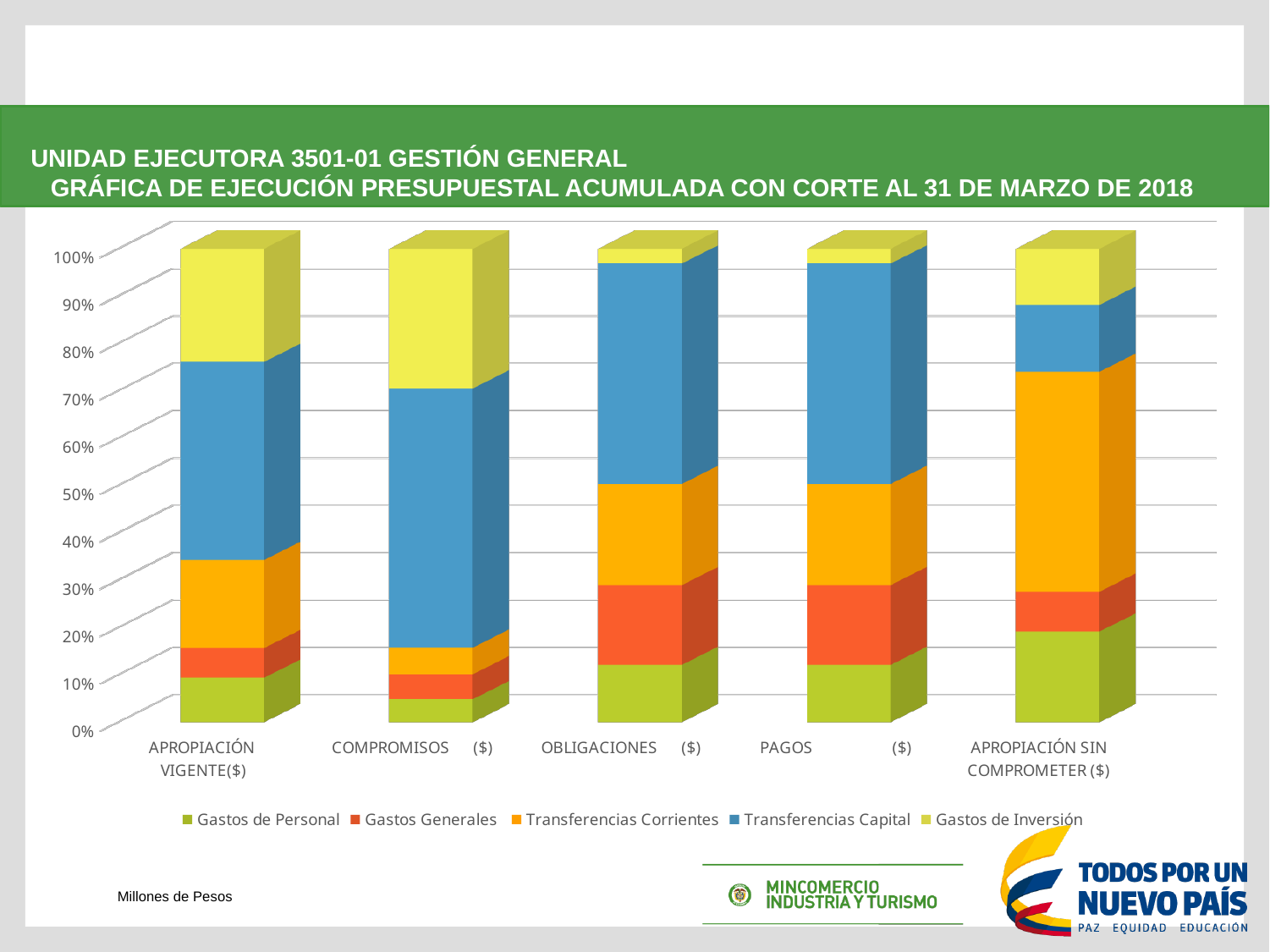
Is the Gastos de Inversión share larger in the COMPROMISOS ($) bar or the OBLIGACIONES ($) bar? COMPROMISOS ($) What kind of chart is shown on the slide? Stacked bar chart Is the Gastos de Personal share in the COMPROMISOS ($) bar greater or less than 10%? less Is the Gastos de Personal share in the APROPIACIÓN SIN COMPROMETER ($) bar greater or less than 10%? greater Which category has the largest Gastos de Inversión share? COMPROMISOS ($) What unit note appears at the bottom left of the slide below the chart? Millones de Pesos How many series does the chart legend list? 5 Which series is shown in blue in the chart legend? Transferencias Capital Which category has the largest Transferencias Corrientes share? APROPIACIÓN SIN COMPROMETER ($) Is the Transferencias Capital share in the COMPROMISOS ($) bar greater or less than 50%? greater How many categories are shown along the x axis of the chart? 5 What does each stacked bar in the chart total? 100%